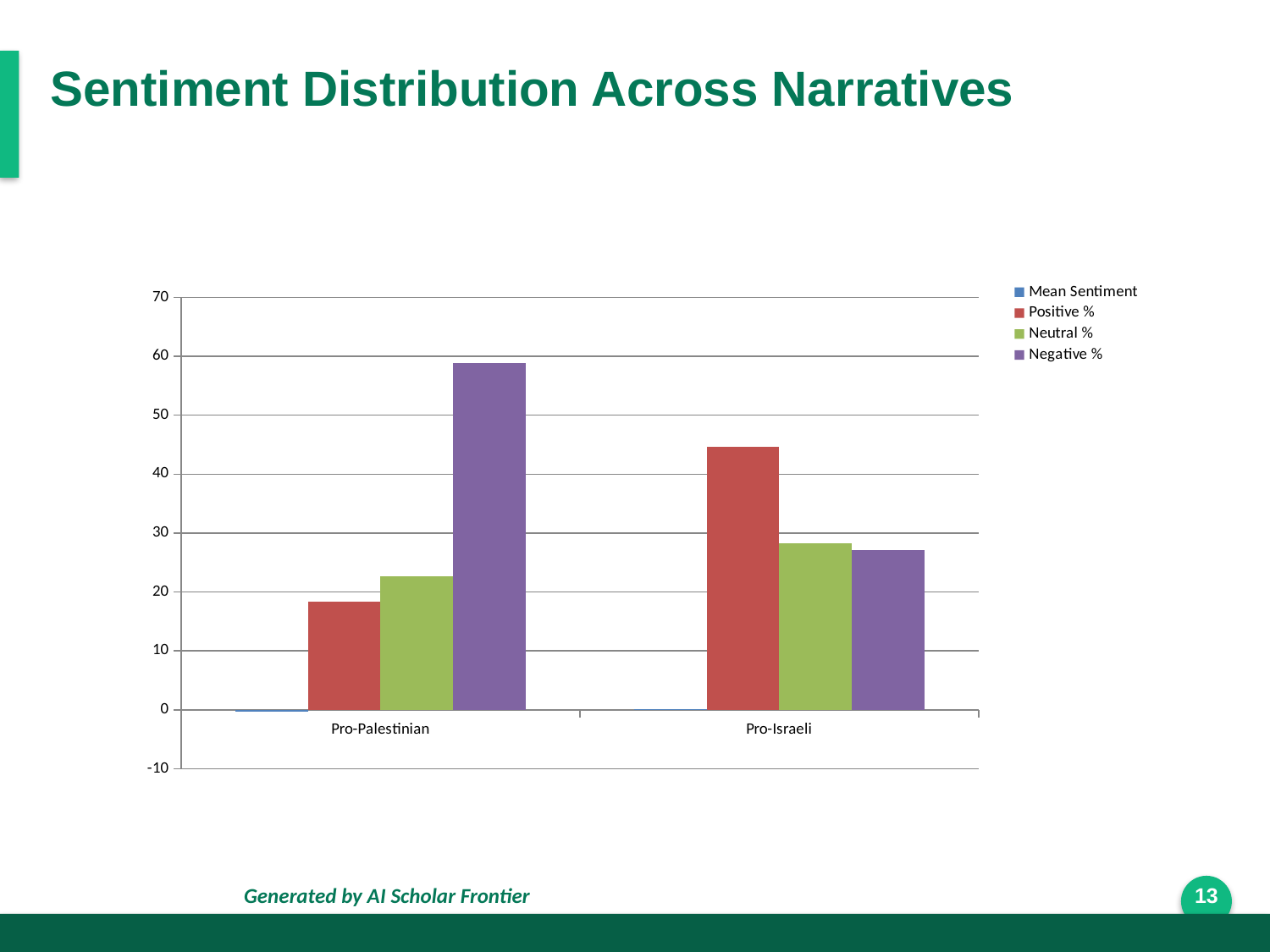
Which category has the larger Positive % value, Pro-Palestinian or Pro-Israeli? Pro-Israeli How many categories are shown on the x axis? 2 Which series has the tallest bar for Pro-Israeli? Positive % Which series has the tallest bar for Pro-Palestinian? Negative % Is the Negative % value for Pro-Israeli greater or less than 30? less Is the Positive % value for Pro-Israeli greater or less than 40? greater How many series does the legend list? 4 Is the Negative % value for Pro-Palestinian greater or less than 50? greater What kind of chart is shown on the slide? bar chart Which category has the larger Negative % value, Pro-Palestinian or Pro-Israeli? Pro-Palestinian What is the title of the slide containing the chart? Sentiment Distribution Across Narratives